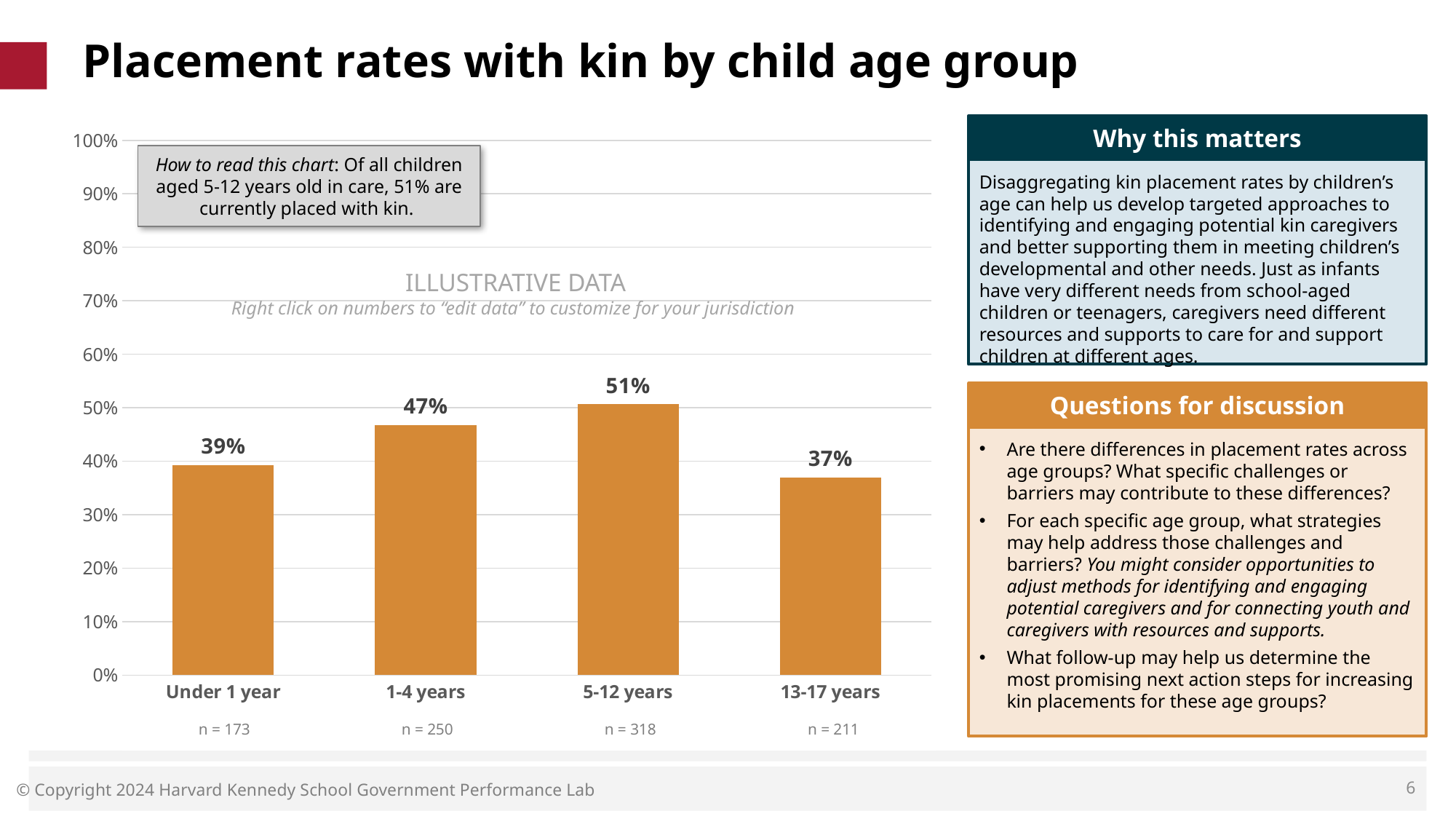
What kind of chart is shown on the slide? bar chart What is the placement rate with kin for children aged 13-17 years? 37% What is the placement rate with kin for children aged 5-12 years? 51% Which has a higher placement rate with kin: 1-4 years or 13-17 years? 1-4 years What is the sample size (n) shown for the 5-12 years group? n = 318 What is the placement rate with kin for children under 1 year? 39% How many age groups are shown in the chart? 4 Is the placement rate for the 1-4 years group greater or less than 50%? less What is the difference in placement rate between the 5-12 years group and the 13-17 years group? 14% What is the difference in placement rate between the 1-4 years group and the under 1 year group? 8% Which age group has the lowest placement rate with kin? 13-17 years Which age group has the highest placement rate with kin? 5-12 years